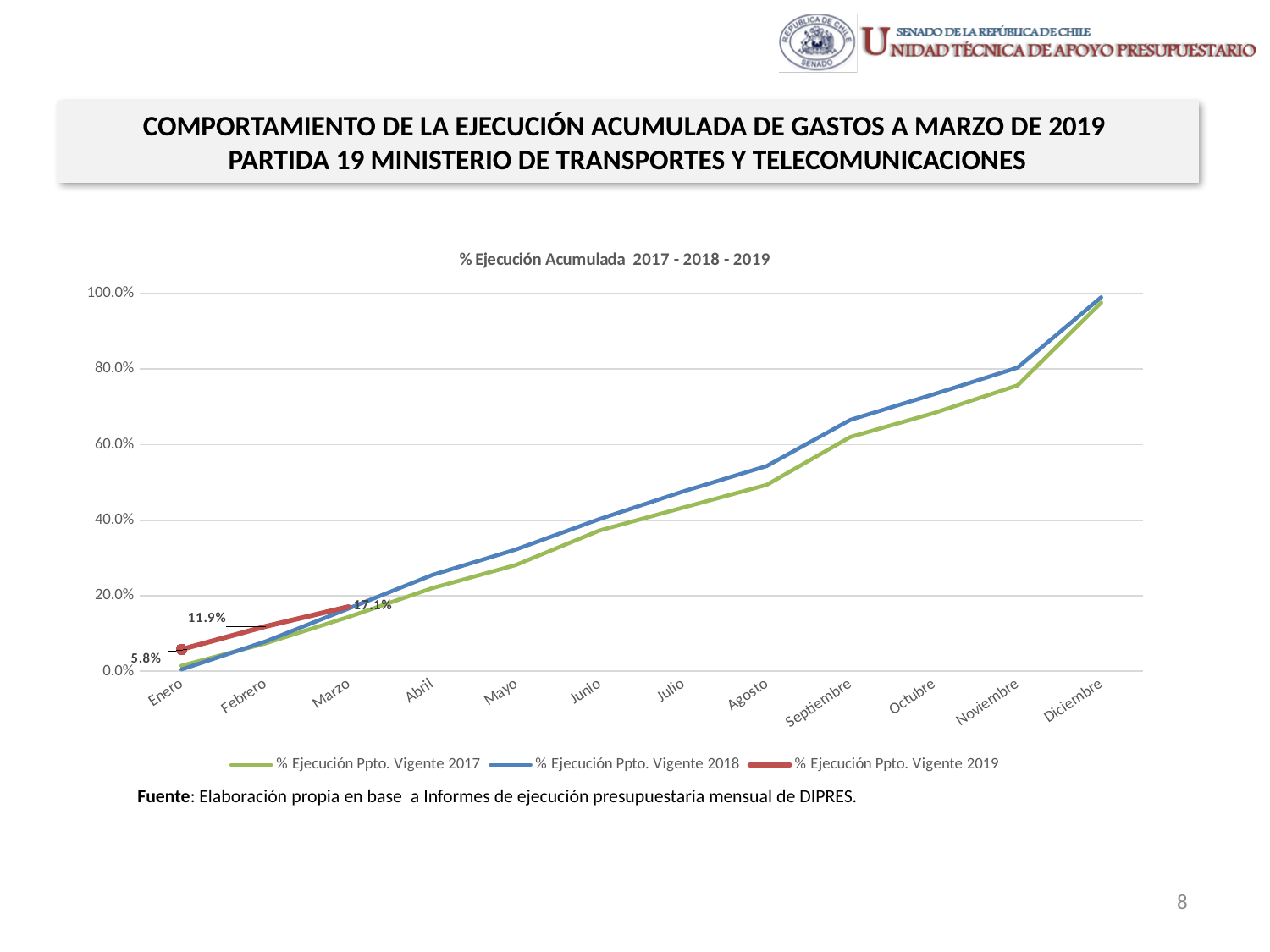
Is the value for % Ejecución Ppto. Vigente 2017 in Agosto greater or less than 60%? less What is the value of % Ejecución Ppto. Vigente 2019 for Marzo? 17.1% How many series does the legend list? 3 How many months are shown on the x axis? 12 What is the title of the chart? % Ejecución Acumulada 2017 - 2018 - 2019 What kind of chart is shown on the slide? Line chart Do the values for % Ejecución Ppto. Vigente 2018 rise or fall from Enero to Diciembre? Rise What is the value of % Ejecución Ppto. Vigente 2019 for Enero? 5.8% By how much did % Ejecución Ppto. Vigente 2019 increase from Enero to Marzo? 11.3% What is the value of % Ejecución Ppto. Vigente 2019 for Febrero? 11.9% What is the difference between the 2019 values for Febrero and Enero? 6.1% In Noviembre, which series is higher: % Ejecución Ppto. Vigente 2017 or % Ejecución Ppto. Vigente 2018? % Ejecución Ppto. Vigente 2018